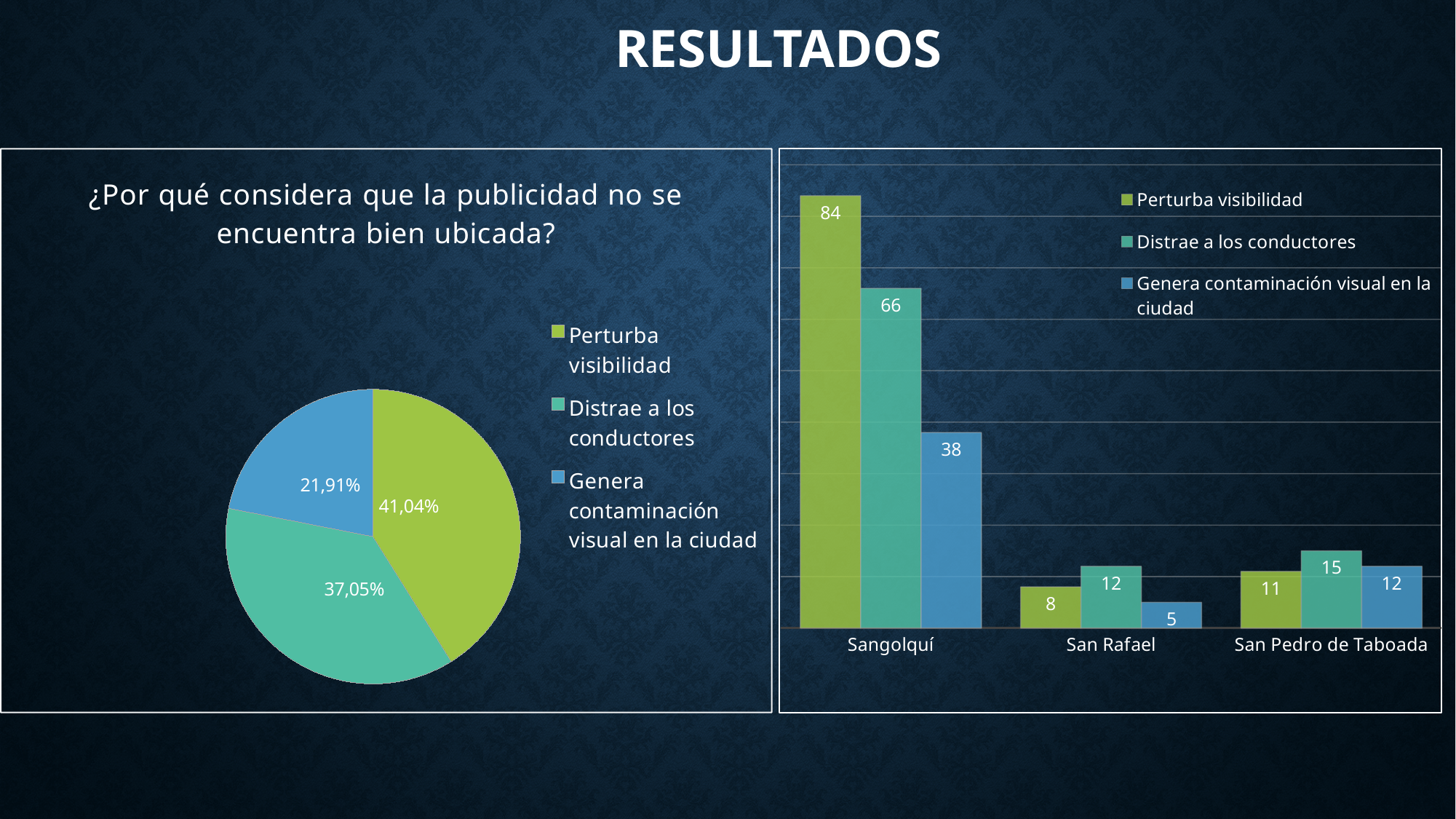
In the bar chart on the right, what is the value for 'Distrae a los conductores' in San Pedro de Taboada? 15 In the bar chart on the right, which is larger: 'Perturba visibilidad' in San Rafael or 'Perturba visibilidad' in San Pedro de Taboada? San Pedro de Taboada In the pie chart on the left, how many slices are there? 3 In the bar chart on the right, what is the value for 'Perturba visibilidad' in Sangolquí? 84 In the pie chart on the left, what share does 'Perturba visibilidad' have? 41,04% What type of chart is shown on the right side of the slide? Bar chart In the pie chart on the left, which category has the smallest slice? Genera contaminación visual en la ciudad In the bar chart on the right, what is the difference between 'Perturba visibilidad' and 'Distrae a los conductores' in Sangolquí? 18 How many series does the legend of the bar chart on the right list? 3 In the pie chart on the left, what share does 'Genera contaminación visual en la ciudad' have? 21,91% In the bar chart on the right, what is the value for 'Genera contaminación visual en la ciudad' in San Rafael? 5 In the bar chart on the right, which location has the highest value for 'Distrae a los conductores'? Sangolquí